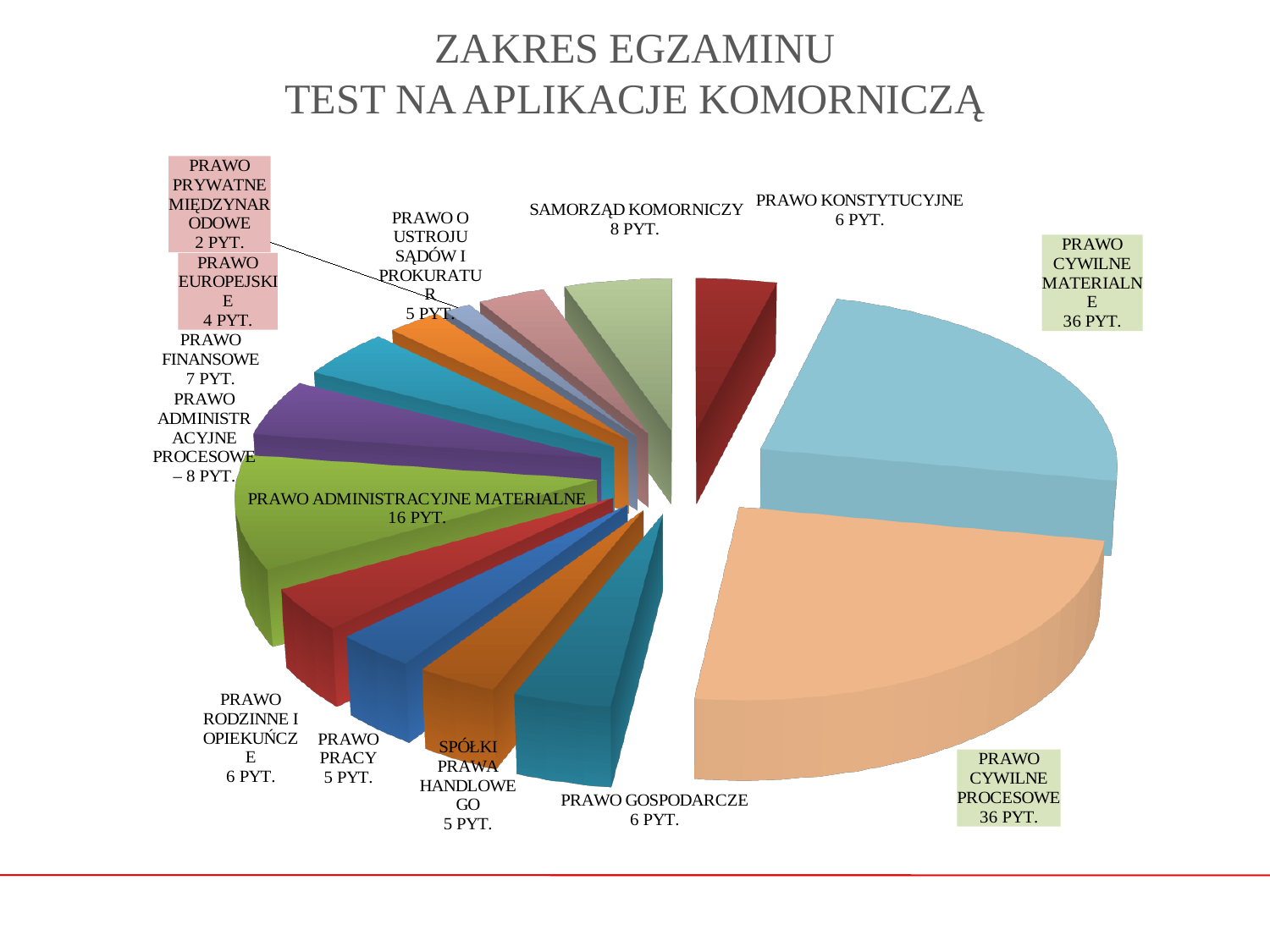
How many questions are shown for SAMORZĄD KOMORNICZY? 8 PYT. What is the title of the chart? ZAKRES EGZAMINU TEST NA APLIKACJE KOMORNICZĄ How many questions are shown for PRAWO FINANSOWE? 7 PYT. What kind of chart is shown on the slide? pie chart Which has more questions, PRAWO EUROPEJSKIE or PRAWO FINANSOWE? PRAWO FINANSOWE What is the largest number of questions shown for any single category? 36 PYT. How many questions are shown for PRAWO CYWILNE PROCESOWE? 36 PYT. What share of all questions does PRAWO CYWILNE MATERIALNE represent? 24% What is the difference in questions between PRAWO CYWILNE MATERIALNE and PRAWO ADMINISTRACYJNE MATERIALNE? 20 Which category has the smallest number of questions? PRAWO PRYWATNE MIĘDZYNARODOWE How many questions (PYT.) are shown for PRAWO ADMINISTRACYJNE MATERIALNE? 16 PYT. How many categories does the pie chart contain? 14